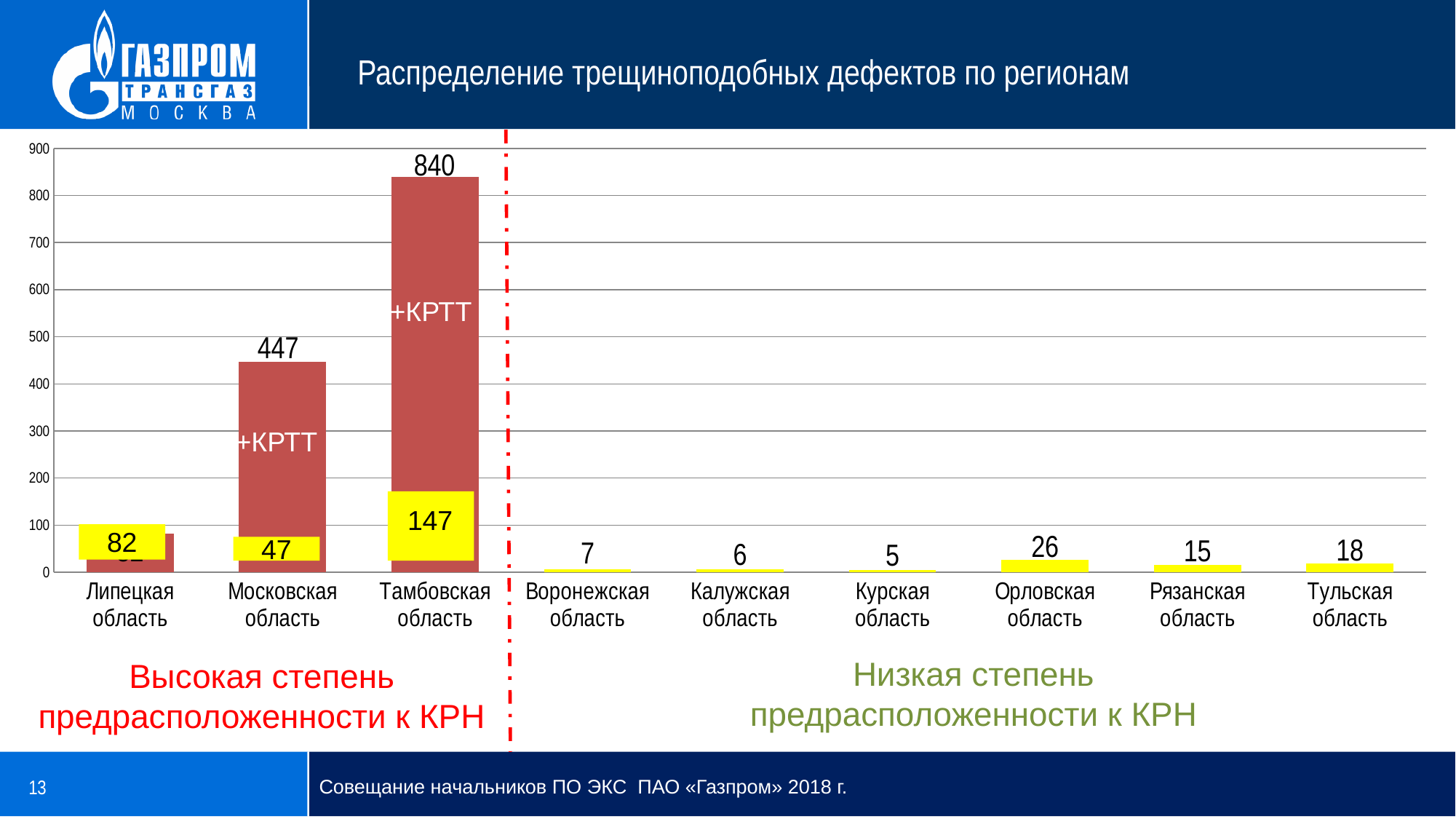
What is the value shown for Курская область? 5 Is the value for the red bar of Московская область greater or less than 400? greater What is the difference between the top values for Тамбовская область (840) and Московская область (447)? 393 What type of chart is shown on the slide? bar chart How many regions are shown on the x axis of the chart? 9 What is the value shown in the yellow box for Тамбовская область? 147 What is the value shown above the tallest bar for Тамбовская область? 840 Which region has the lowest value on the chart? Курская область Which region has the highest bar on the chart? Тамбовская область What is the value shown above the red bar for Московская область? 447 What is the value shown for Орловская область? 26 Which is larger, the value for Рязанская область or Тульская область? Тульская область